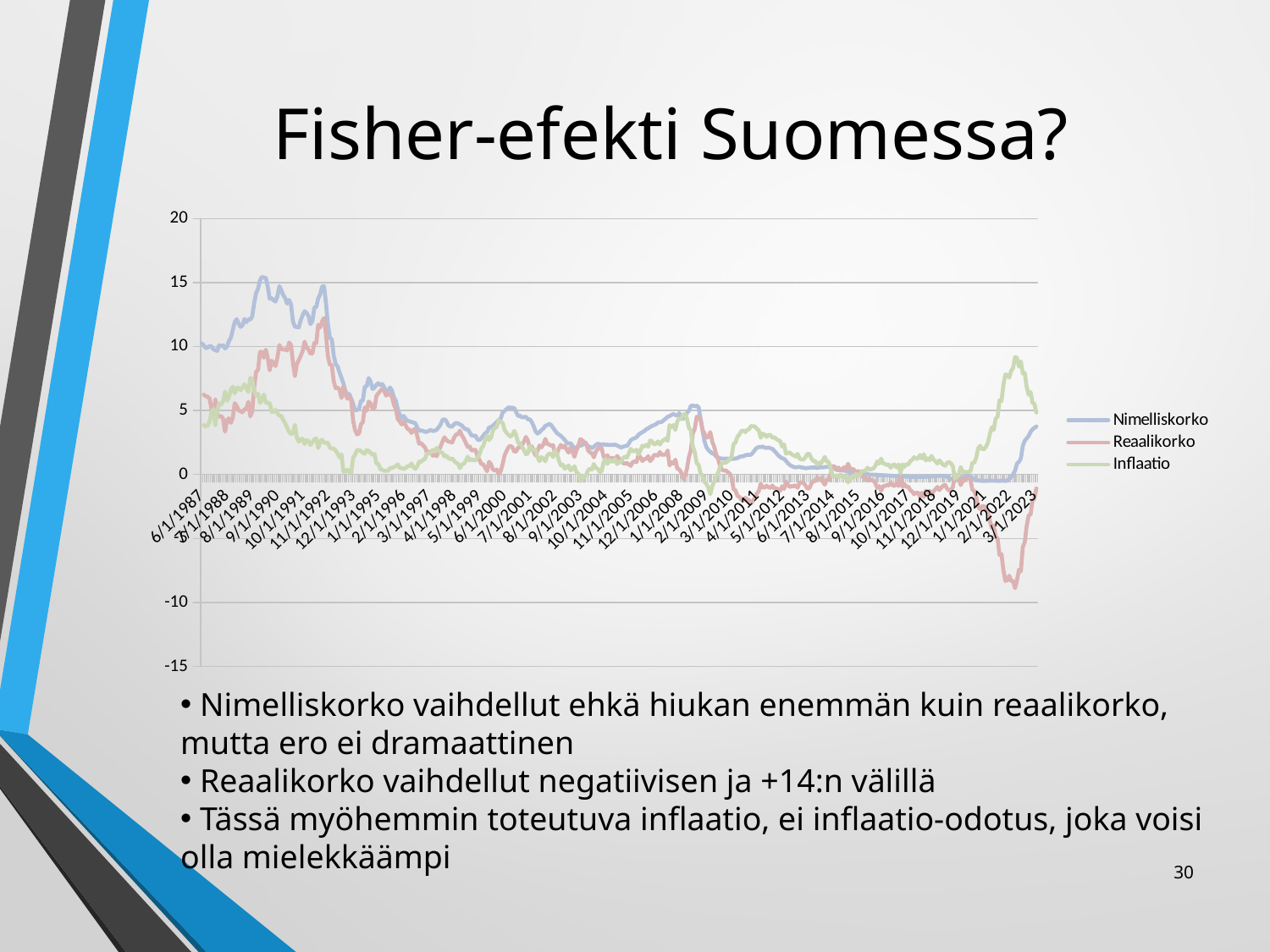
Does the Nimelliskorko series generally rise or fall between 1990 and 2015? fall Is the peak value of Nimelliskorko around 1990 greater or less than 10? greater What kind of chart is shown on the slide? line chart Is the peak value of Inflaatio around 2022 greater or less than 5? greater What is the highest value shown on the vertical axis? 20 Around 1990, which is larger: Nimelliskorko or Inflaatio? Nimelliskorko How many series does the legend list? 3 Which series reaches the lowest value anywhere on the chart? Reaalikorko Which colour is used for the Inflaatio series? green Is the lowest value of Reaalikorko around 2022 greater or less than -5? less What are the three series named in the legend? Nimelliskorko, Reaalikorko, Inflaatio Which series reaches the highest value anywhere on the chart? Nimelliskorko